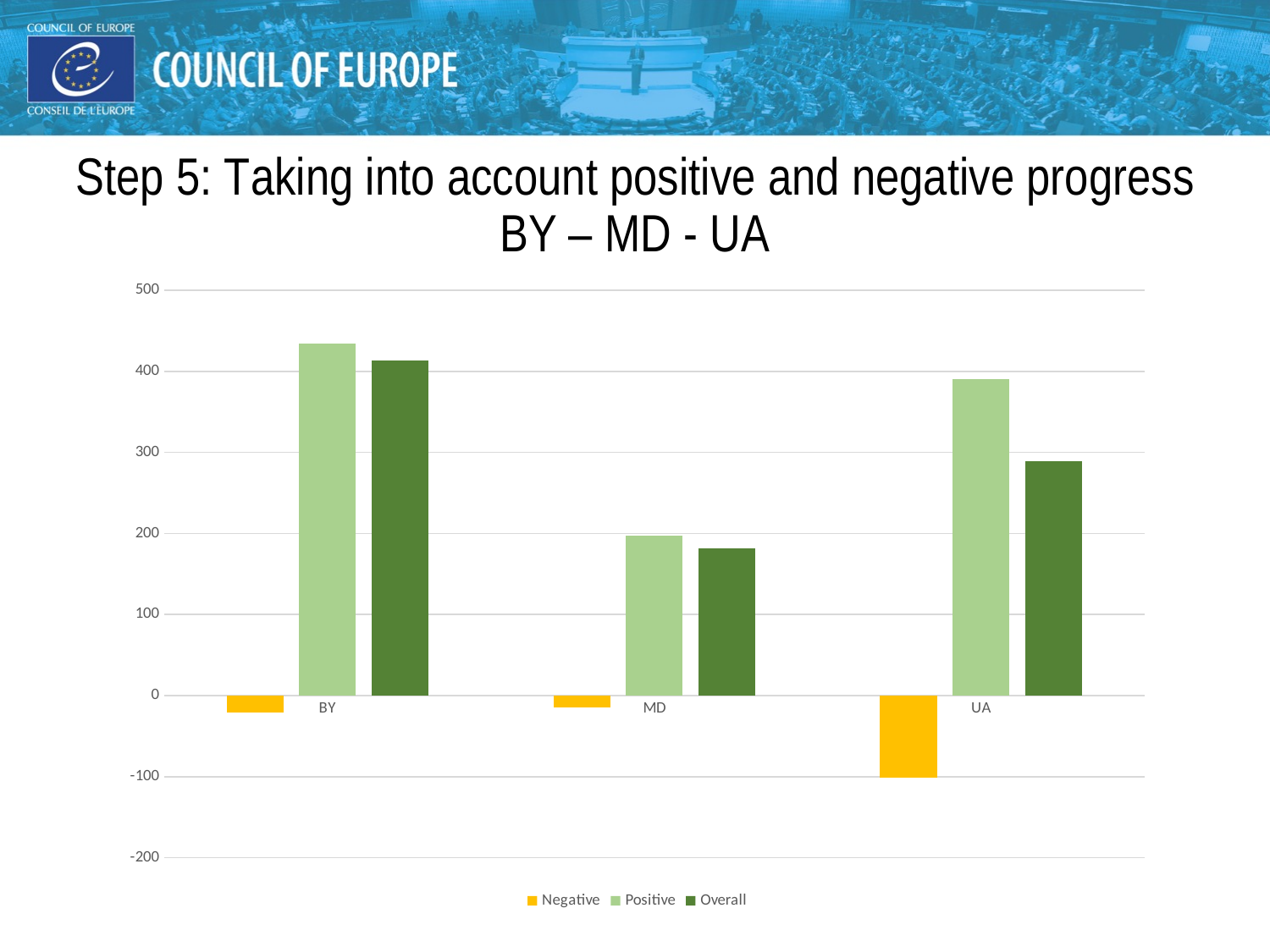
Which category has the highest Positive value? BY Is the Overall value for MD greater or less than 200? less Which category has the lowest Negative value? UA Is the Overall value for UA greater or less than 200? greater How many categories are shown on the x axis of the chart? 3 What kind of chart is shown on the slide? bar chart Which category has the highest Overall value? BY Which is larger, the Positive value for BY or the Positive value for UA? BY Is the Positive value for BY greater or less than 400? greater What colour represents the Negative series in the chart? yellow How many series does the chart's legend list? 3 Which category has the lowest Positive value? MD